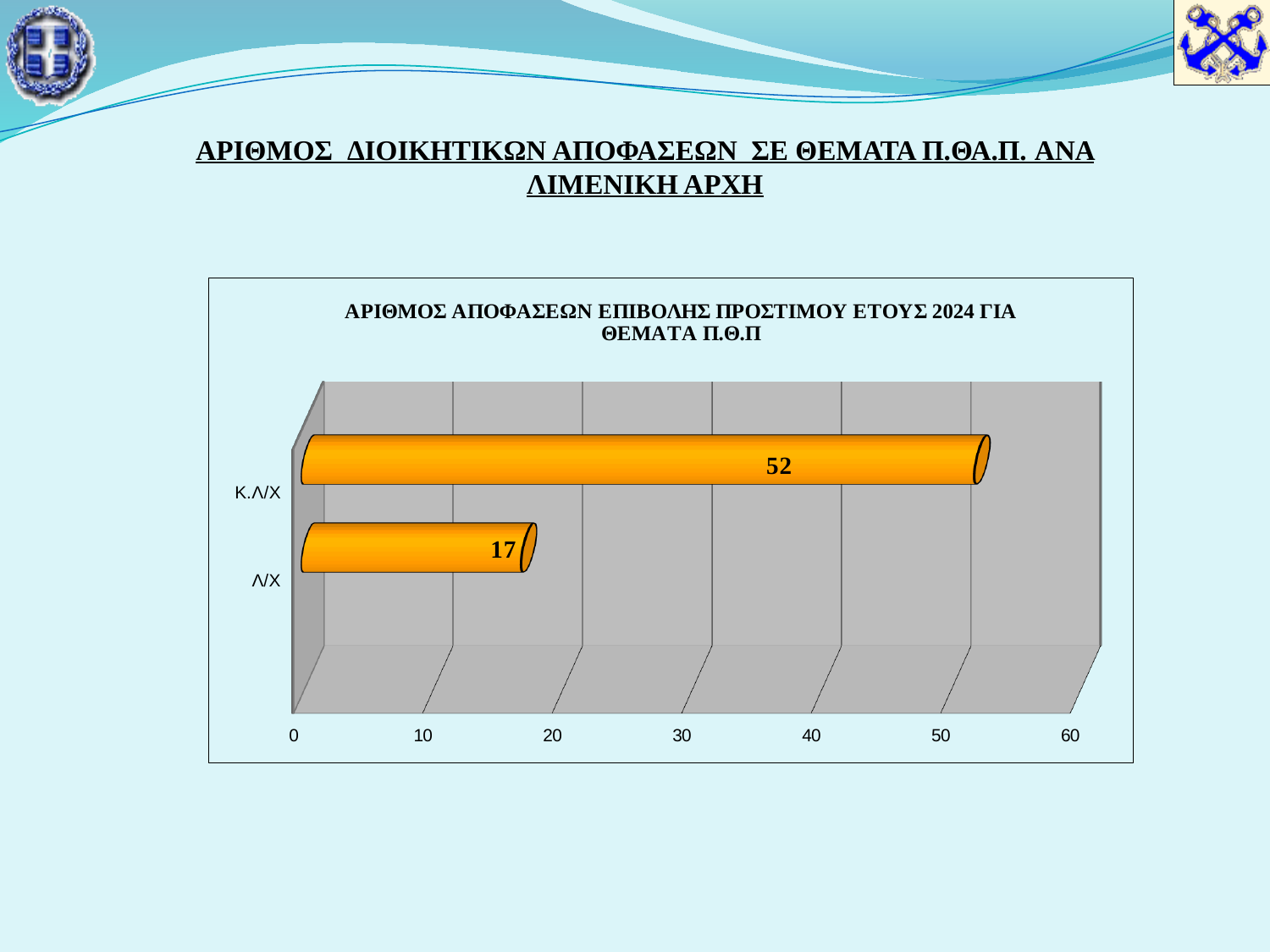
What is the value for Λ/Χ? 17 Is the value for Λ/Χ greater or less than 20? less What is the total of the two values shown in the chart? 69 Which category has the lowest value? Λ/Χ What is the difference between the values for Κ.Λ/Χ and Λ/Χ? 35 What is the value for Κ.Λ/Χ? 52 How many categories are shown in the chart? 2 Is the value for Κ.Λ/Χ greater or less than 50? greater Which category has the highest value? Κ.Λ/Χ What is the highest value shown on the x axis of the chart? 60 Which is larger, the value for Κ.Λ/Χ or the value for Λ/Χ? Κ.Λ/Χ What kind of chart is shown on the slide? bar chart